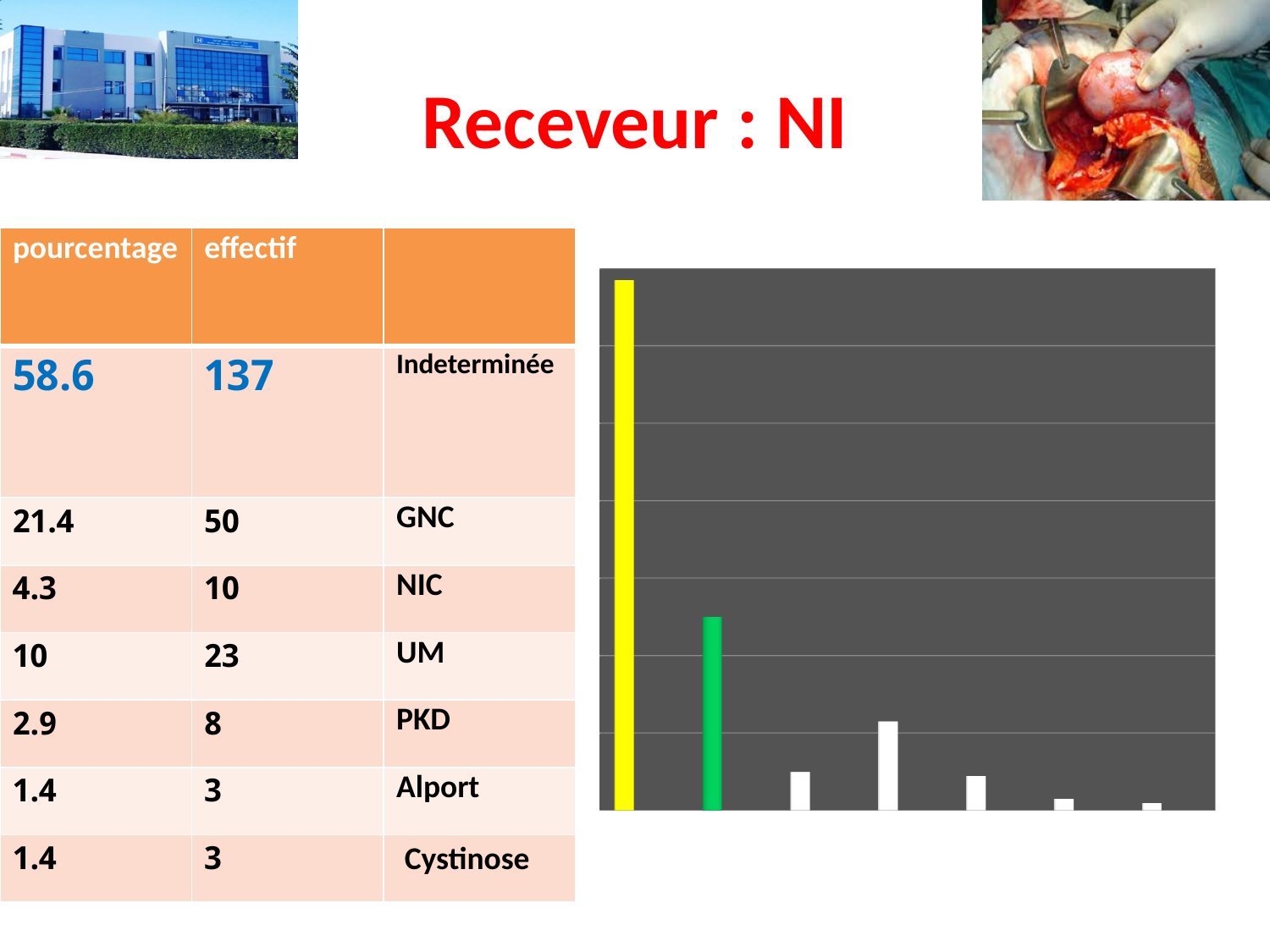
Does the chart display a legend? No What colour is the second bar from the left in the chart? green What kind of chart is shown on the right side of the slide? bar chart What colour is the tallest bar in the chart? yellow How many bars does the chart on the right side of the slide contain? 7 Is the third bar from the left taller or shorter than the fourth bar from the left in the chart? shorter Which bar in the chart is the tallest, by position from the left? the first bar Is the second bar from the left taller or shorter than the fourth bar from the left in the chart? taller